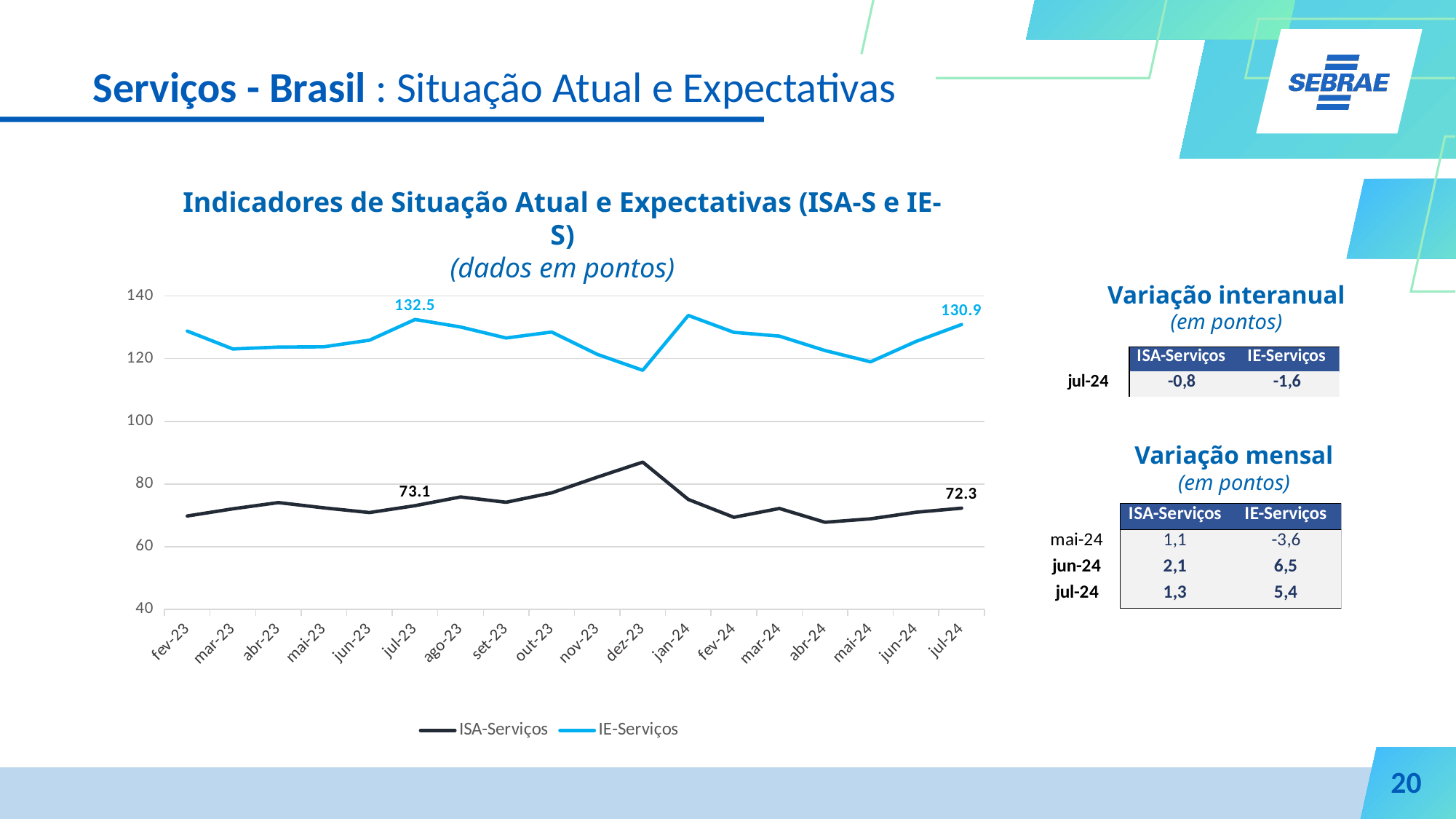
What is the value of IE-Serviços in jul-24? 130.9 In which month does ISA-Serviços reach its highest value? dez-23 How many series does the chart legend list? 2 What is the value of ISA-Serviços in jul-24? 72.3 What is the difference between the IE-Serviços and ISA-Serviços values in jul-24? 58.6 What is the value of IE-Serviços in jul-23? 132.5 What type of chart is shown on the slide? line chart What is the value of ISA-Serviços in jul-23? 73.1 Is the value for IE-Serviços in dez-23 greater or less than 120? less What is the difference between the IE-Serviços values in jul-23 and jul-24? 1.6 Is the value for ISA-Serviços in dez-23 greater or less than 80? greater How many months are plotted along the x axis of the chart? 18